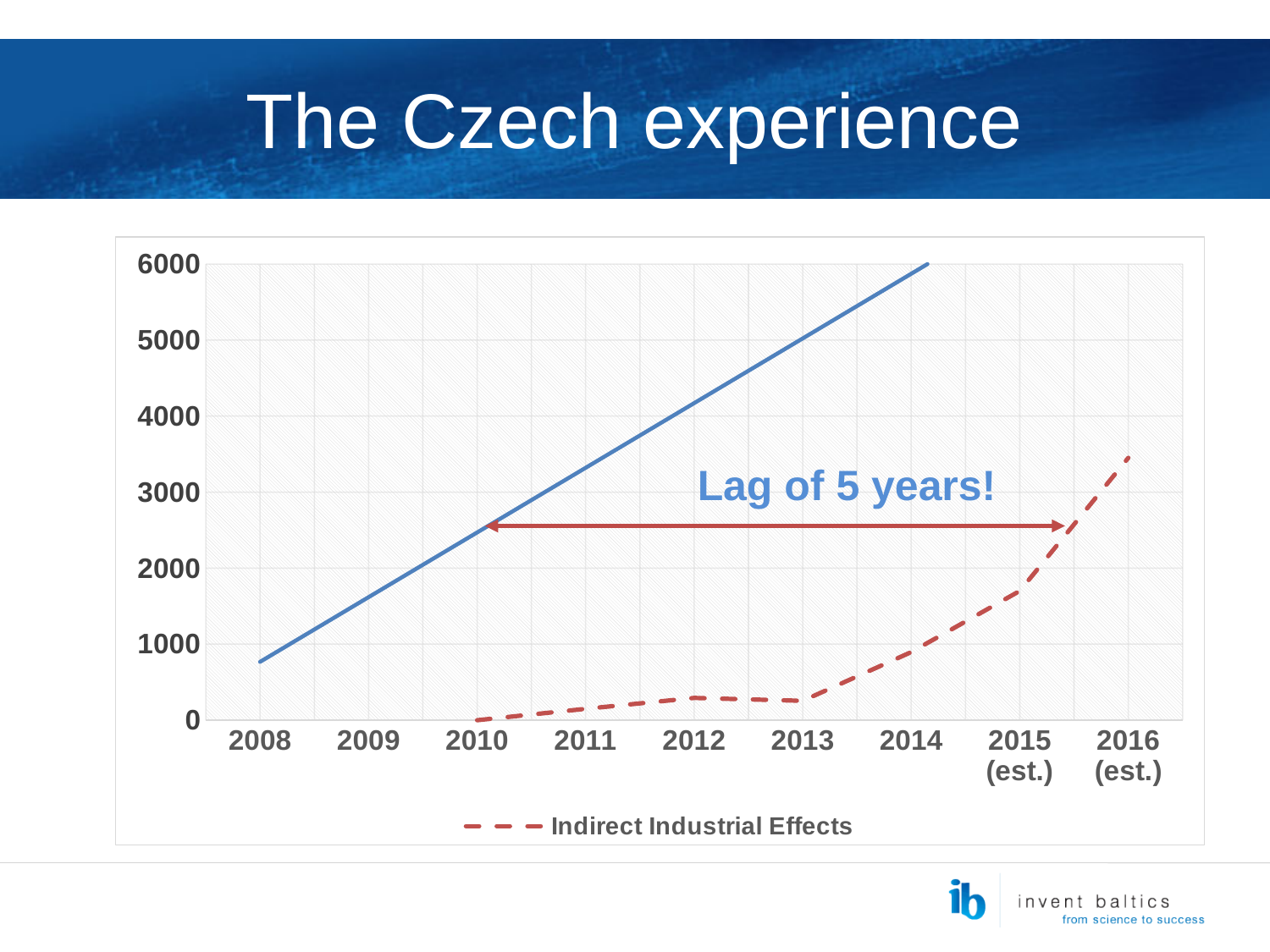
How many series does the chart legend list? 1 How many years are labelled on the x axis of the chart? 9 Is the value of Indirect Industrial Effects for 2016 (est.) greater or less than 3000? greater Is the value of the solid blue line for 2008 greater or less than 1000? less Is the value of Indirect Industrial Effects for 2013 greater or less than 1000? less Do the values of Indirect Industrial Effects rise or fall from 2010 to 2016 (est.)? rise What kind of chart is shown on the slide? line chart In 2014, which is larger: the solid blue line or the dashed Indirect Industrial Effects line? the solid blue line What is the name of the series listed in the legend? Indirect Industrial Effects What does the annotation text inside the chart say? Lag of 5 years!